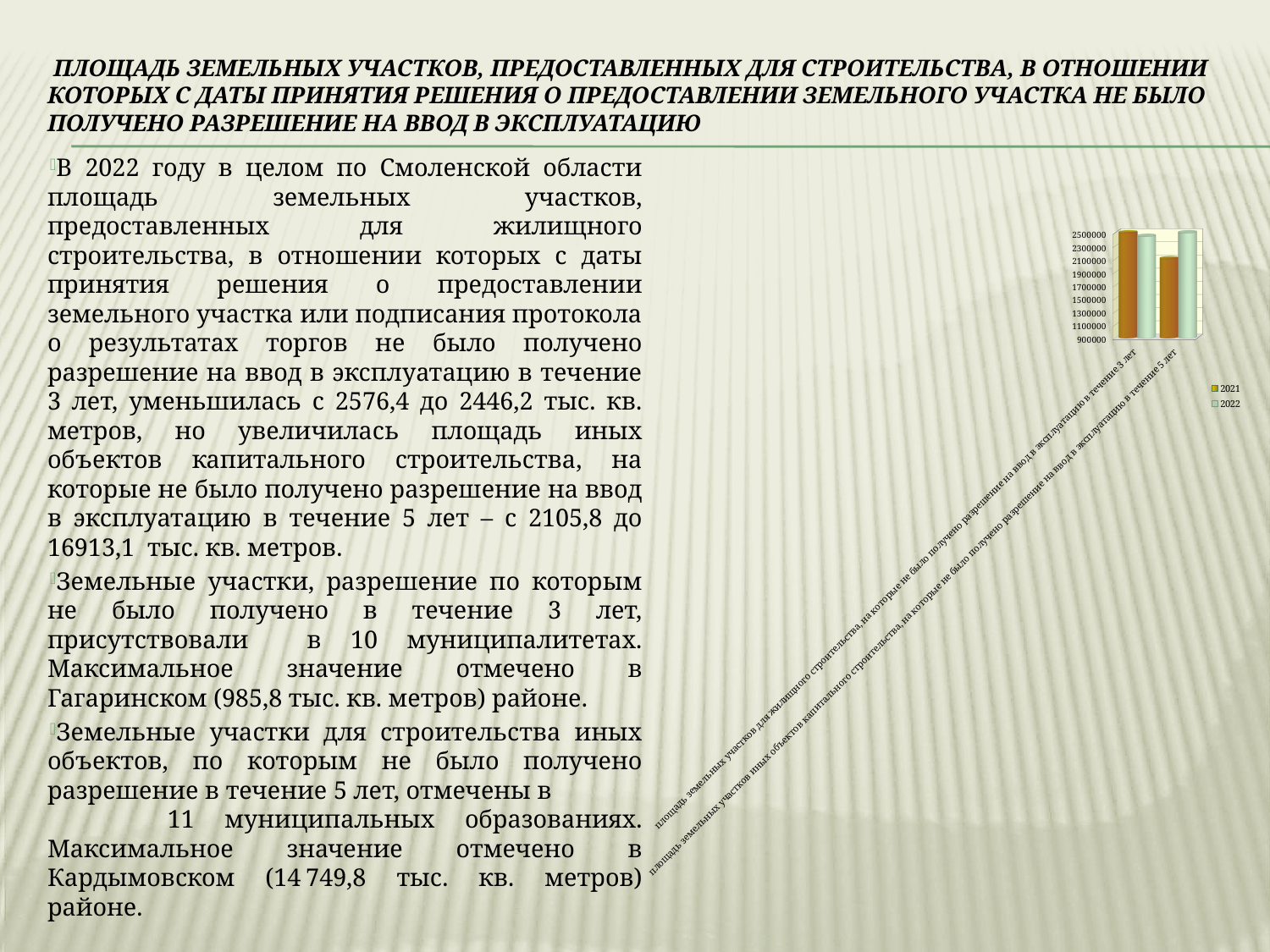
What kind of chart is shown on the right side of the slide? bar chart Is the 2021 value for the category 'площадь земельных участков иных объектов капитального строительства... в течение 5 лет' greater or less than 1900000? greater Is the 2022 value for the category 'площадь земельных участков для жилищного строительства... в течение 3 лет' greater or less than 2100000? greater How many series does the chart legend list? 2 Which series has the lowest bar on the chart, 2021 or 2022? 2021 Is the 2021 value for the category 'площадь земельных участков иных объектов капитального строительства... в течение 5 лет' greater or less than 2300000? less What is the highest tick value shown on the chart's vertical axis? 2500000 How many categories are plotted on the chart's x axis? 2 Which years are listed in the chart legend? 2021 and 2022 For the category 'площадь земельных участков иных объектов капитального строительства... в течение 5 лет', which series has the taller bar, 2021 or 2022? 2022 For the category 'площадь земельных участков для жилищного строительства... в течение 3 лет', which series has the taller bar, 2021 or 2022? 2021